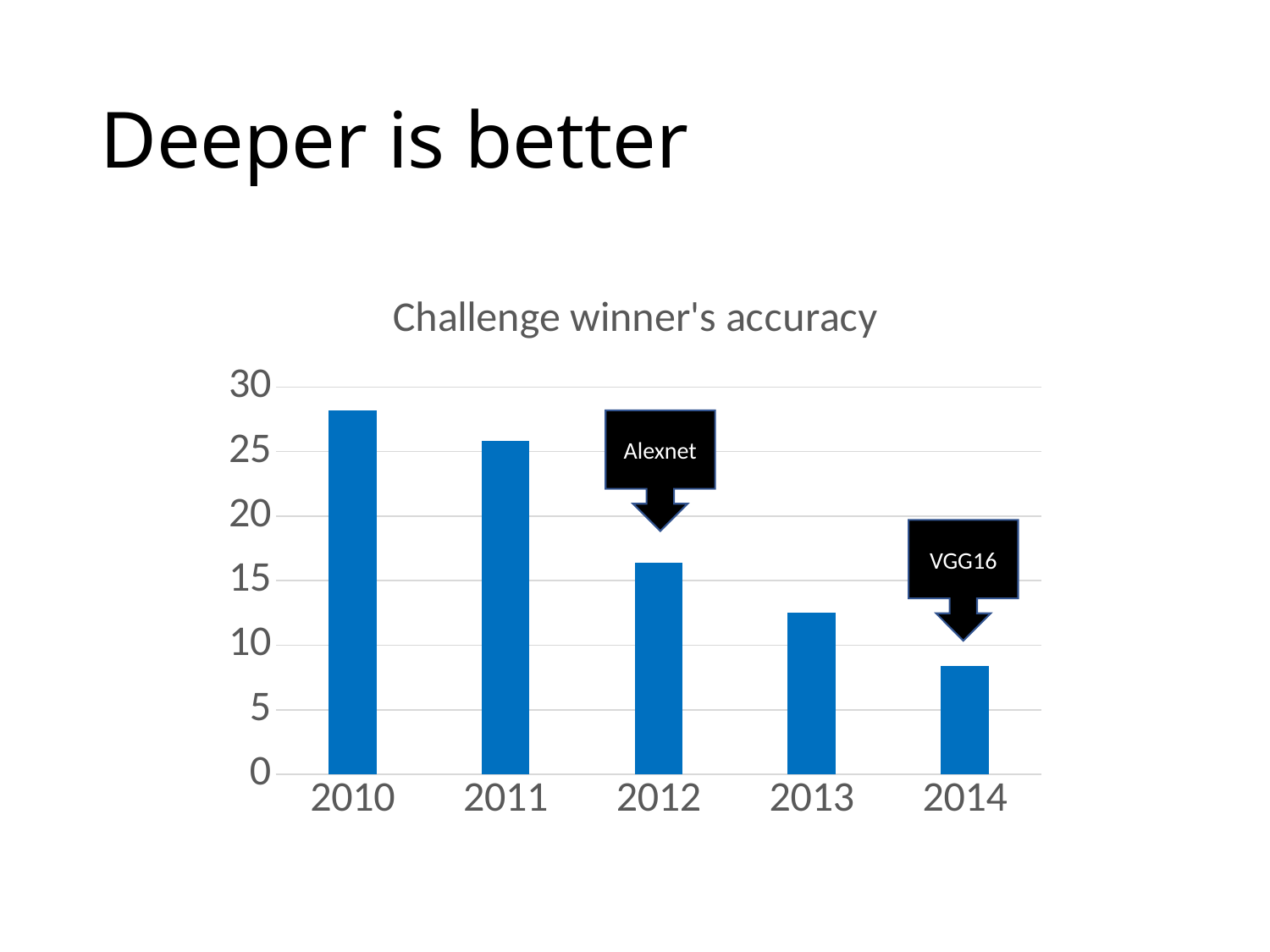
Which year has the larger value, 2012 or 2013? 2012 How many years are shown on the x axis of the chart? 5 Which year has the lowest bar in the chart? 2014 Do the values rise or fall from 2010 to 2014? fall Which year has the highest bar in the chart? 2010 What is the title of the chart? Challenge winner's accuracy Is the value for 2010 greater or less than 25? greater Is the value for 2013 greater or less than 15? less Which model is labelled by the callout pointing at the 2012 bar? Alexnet Is the value for 2014 greater or less than 10? less What type of chart is shown on the slide? bar chart